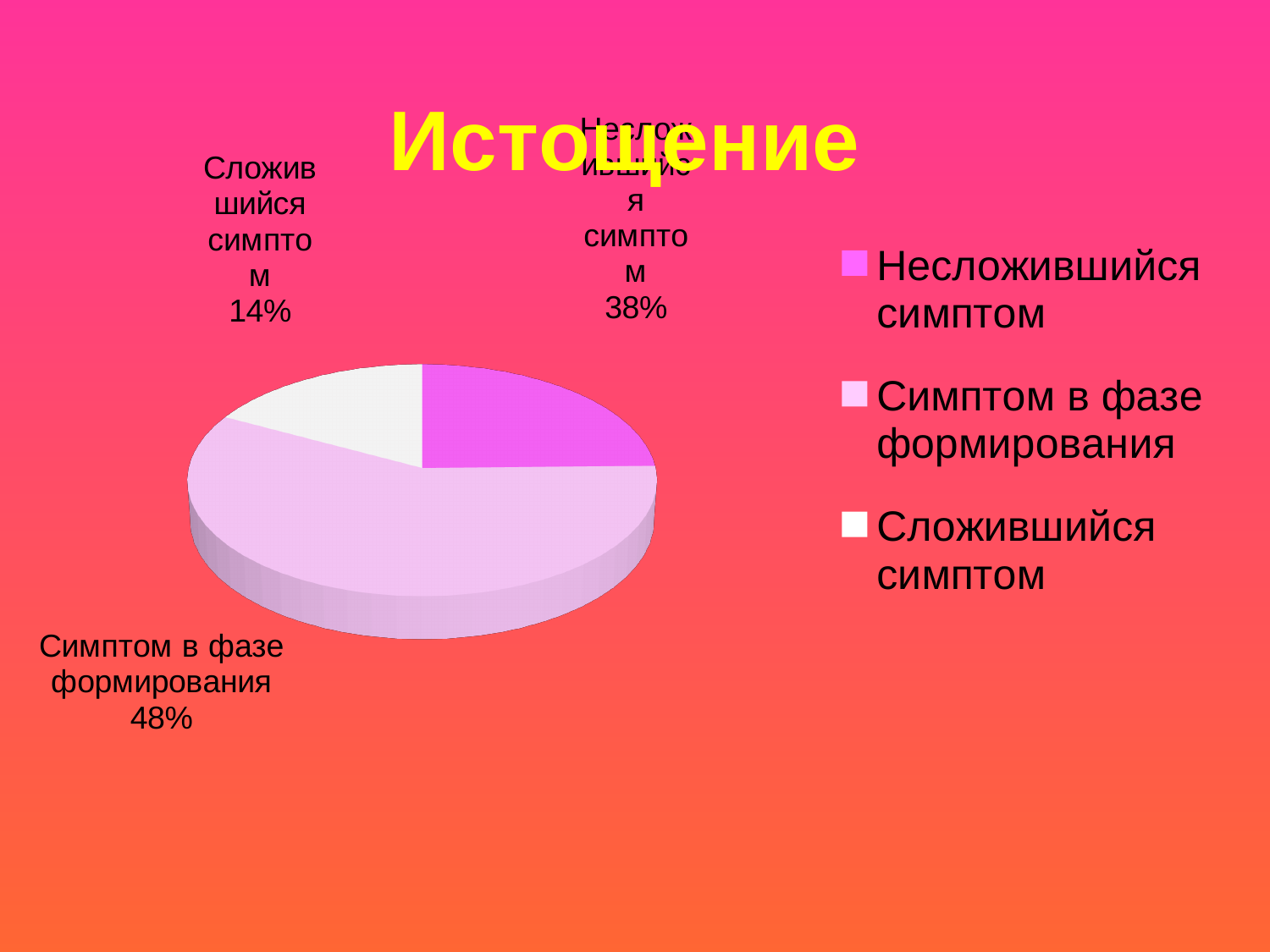
How many entries does the legend list? 3 Which category has the smallest slice of the pie? Сложившийся симптом Which legend entry is shown in white? Сложившийся симптом What is the title of the chart on the slide? Истощение What is the difference in percentage points between "Симптом в фазе формирования" and "Несложившийся симптом"? 10% What share of the pie does "Симптом в фазе формирования" take? 48% What share of the pie does "Несложившийся симптом" take? 38% Which is larger: the share for "Несложившийся симптом" or the share for "Сложившийся симптом"? Несложившийся симптом What share of the pie does "Сложившийся симптом" take? 14% How many slices does the pie chart have? 3 What kind of chart is shown on the slide? Pie chart Which category has the largest slice of the pie? Симптом в фазе формирования